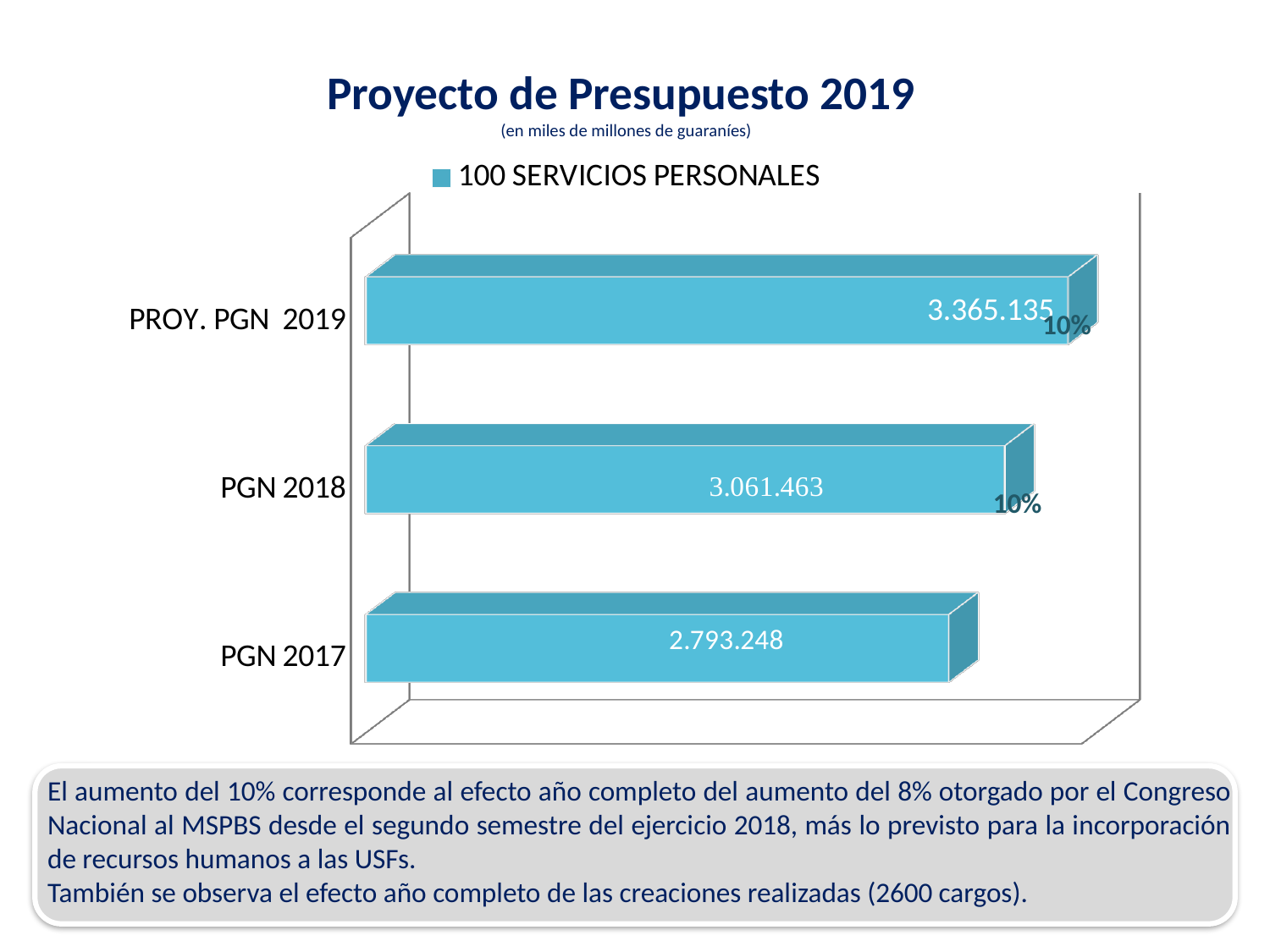
What is the value for PGN 2017? 2.793.248 What is the difference between the values for PROY. PGN 2019 and PGN 2018? 303.672 How many series does the legend list? 1 What is the series name shown in the legend? 100 SERVICIOS PERSONALES Which category has the lowest value? PGN 2017 Which is larger, the value for PGN 2018 or the value for PGN 2017? PGN 2018 What kind of chart is shown on the slide? Bar chart What is the value for PROY. PGN 2019? 3.365.135 How many categories are shown in the chart? 3 What is the difference between the values for PGN 2018 and PGN 2017? 268.215 Which category has the highest value? PROY. PGN 2019 What is the value for PGN 2018? 3.061.463